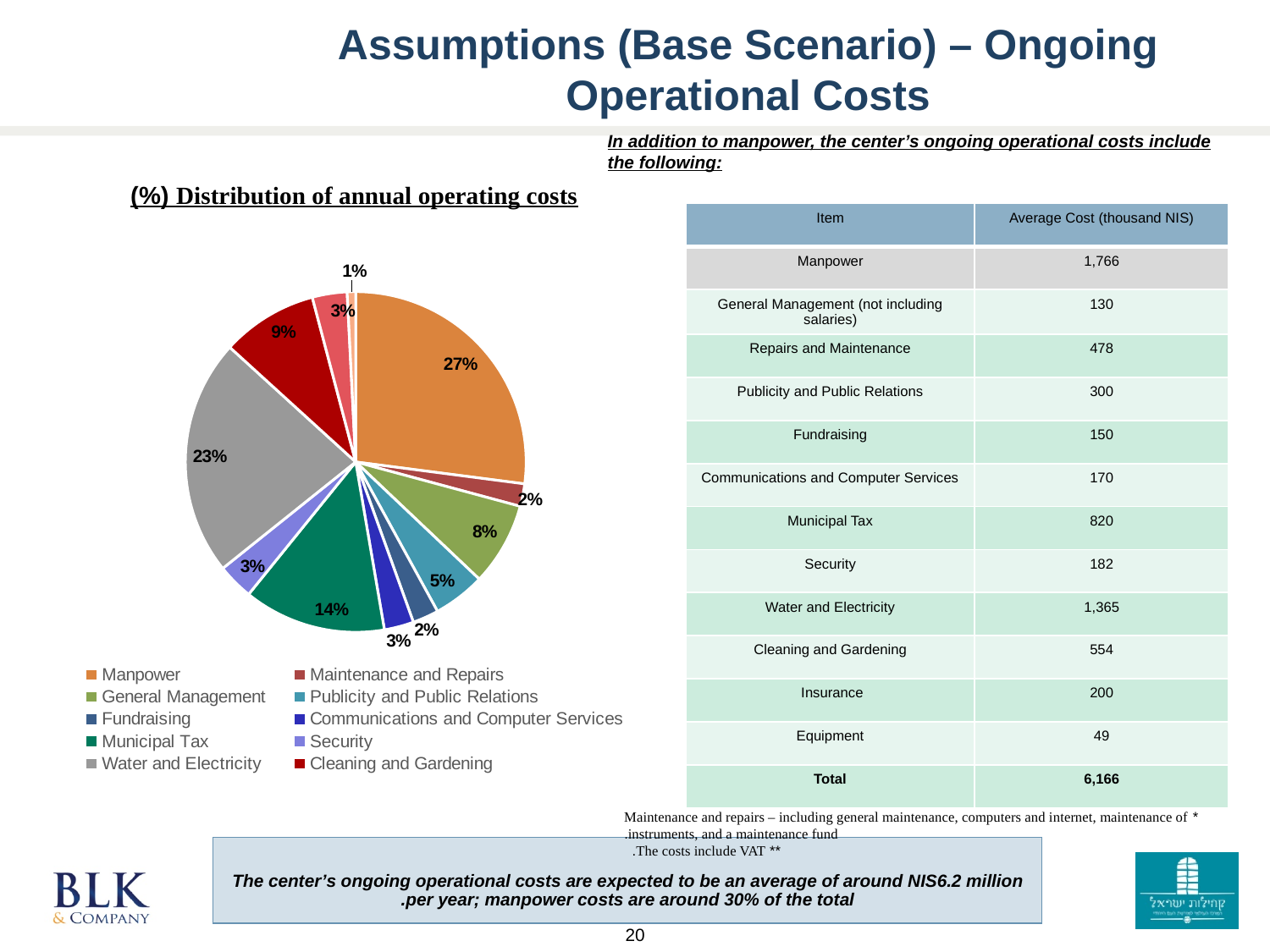
How many entries does the pie chart's legend list? 10 What share of the pie chart is Municipal Tax? 14% What kind of chart is shown on the slide? Pie chart What is the smallest percentage labelled on the pie chart? 1% What percentage of annual operating costs does Manpower account for in the pie chart? 27% By how many percentage points does Manpower exceed Water and Electricity in the pie chart? 4 percentage points Which category has the largest slice in the pie chart? Manpower What percentage is shown for Publicity and Public Relations in the pie chart? 5% What percentage does Water and Electricity represent in the pie chart? 23% What percentage is shown for Cleaning and Gardening in the pie chart? 9% What is the title of the pie chart? (%) Distribution of annual operating costs Which is larger in the pie chart, Municipal Tax or Cleaning and Gardening? Municipal Tax